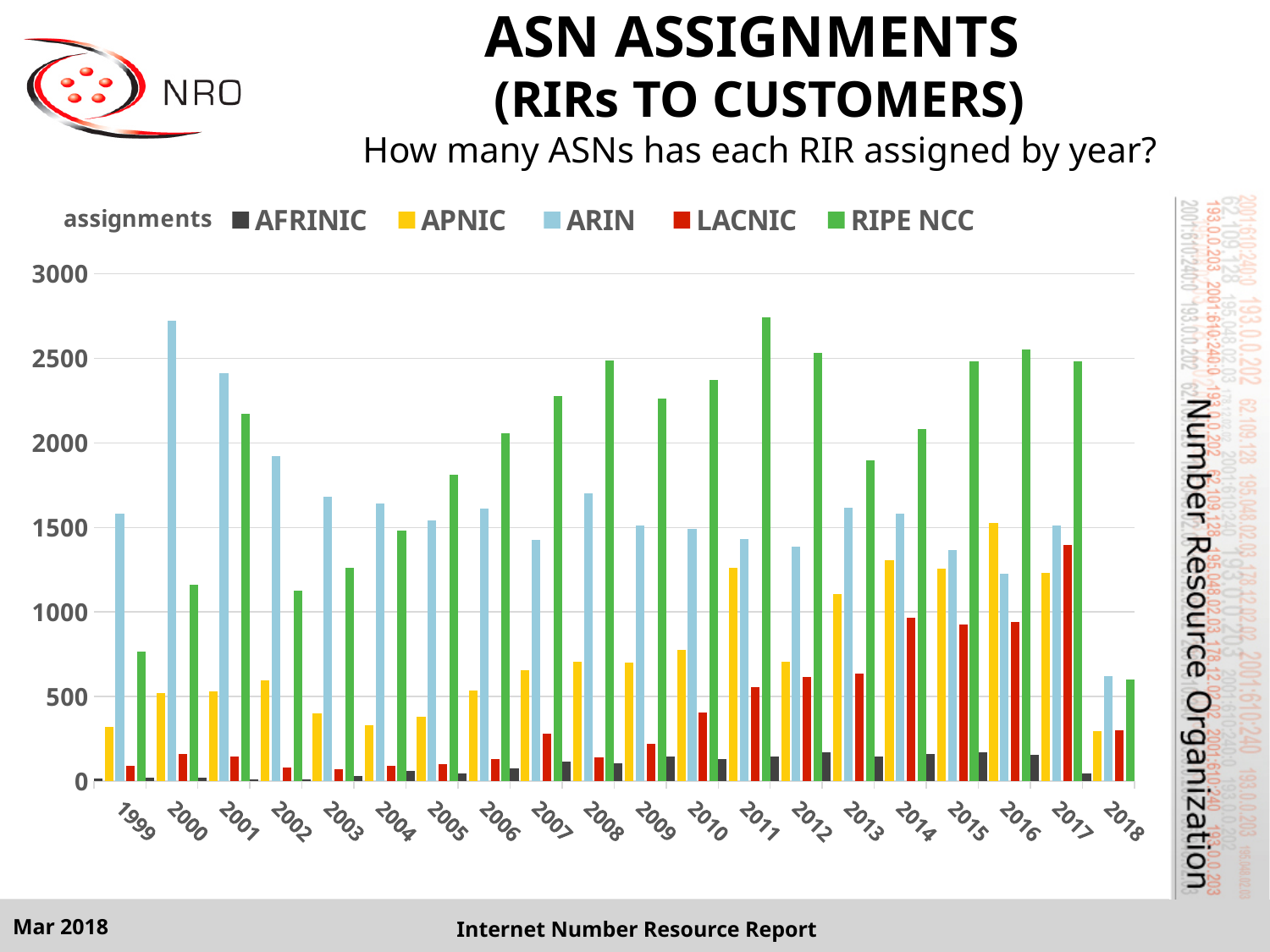
Do the LACNIC values generally rise or fall from 1999 to 2017? rise In which year is the ARIN bar highest? 2000 Is the value for LACNIC in 2017 greater or less than 1000? greater In 2017, which is larger: ARIN or RIPE NCC? RIPE NCC Which RIR has the lowest bars across the chart? AFRINIC Is the value for ARIN in 2000 greater or less than 2500? greater How many years are shown along the x axis? 20 Is the value for RIPE NCC in 1999 greater or less than 1000? less In which year is the RIPE NCC bar highest? 2011 What kind of chart is shown on the slide? bar chart How many series does the legend list? 5 In 2000, which is larger: ARIN or RIPE NCC? ARIN